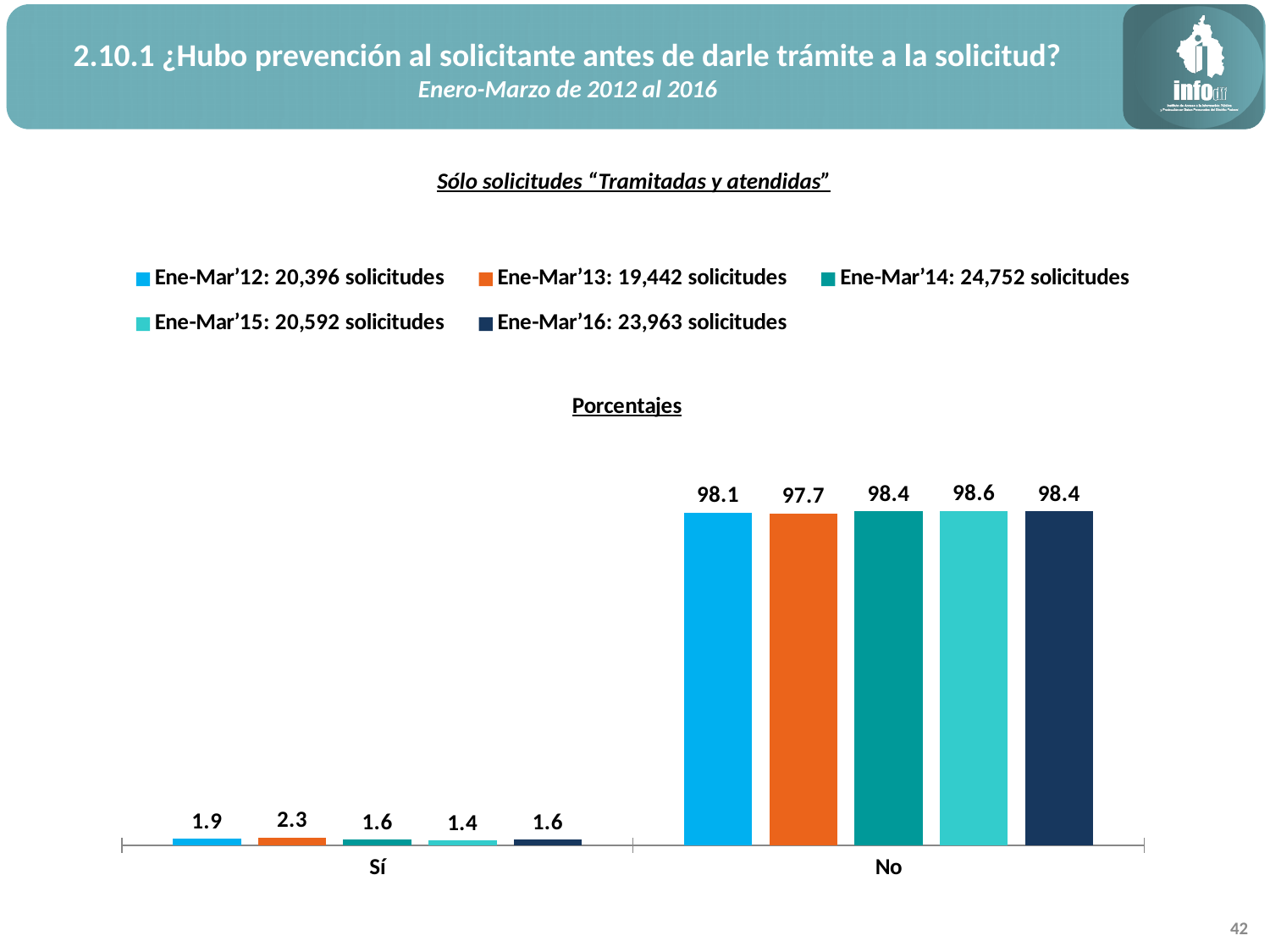
What is the value for Ene-Mar'15 in the Sí category? 1.4 What is the difference between the Ene-Mar'13 and Ene-Mar'15 values in the Sí category? 0.9 How many categories are shown on the x axis? 2 Which is larger in the No category: Ene-Mar'12 or Ene-Mar'15? Ene-Mar'15 What is the value for Ene-Mar'12 in the Sí category? 1.9 What is the value for Ene-Mar'16 in the No category? 98.4 Which series has the lowest value in the No category? Ene-Mar'13 According to the legend, how many solicitudes were there in Ene-Mar'14? 24,752 Which series has the highest value in the Sí category? Ene-Mar'13 What kind of chart is shown on the slide? bar chart What is the value for Ene-Mar'13 in the No category? 97.7 How many series does the legend list? 5